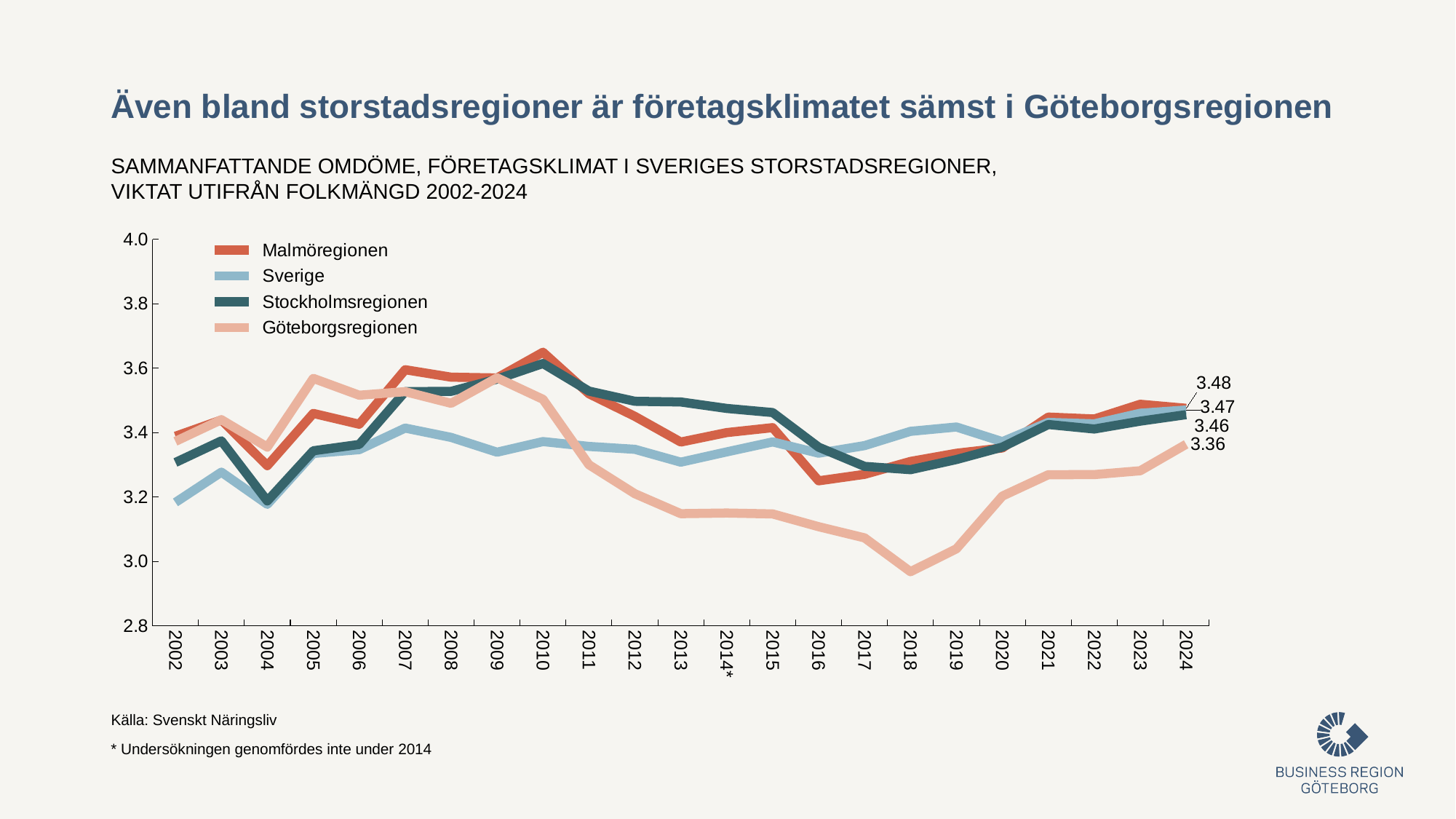
Is the value for Malmöregionen in 2010 greater or less than 3.6? greater Which series has the lowest value in 2024? Göteborgsregionen What is the value for Göteborgsregionen in 2024? 3.36 What kind of chart is shown on the slide? line chart How many series does the legend list? 4 What is the difference between the highest and the lowest labelled value in 2024? 0.12 Does the Göteborgsregionen line rise or fall between 2010 and 2018? fall According to the footnote, in which year was the survey not carried out? 2014 How many years are shown on the x axis? 23 Is the value for Göteborgsregionen in 2018 greater or less than 3.0? less What is the value for Stockholmsregionen in 2024? 3.46 Which is higher in 2004, Malmöregionen or Sverige? Malmöregionen